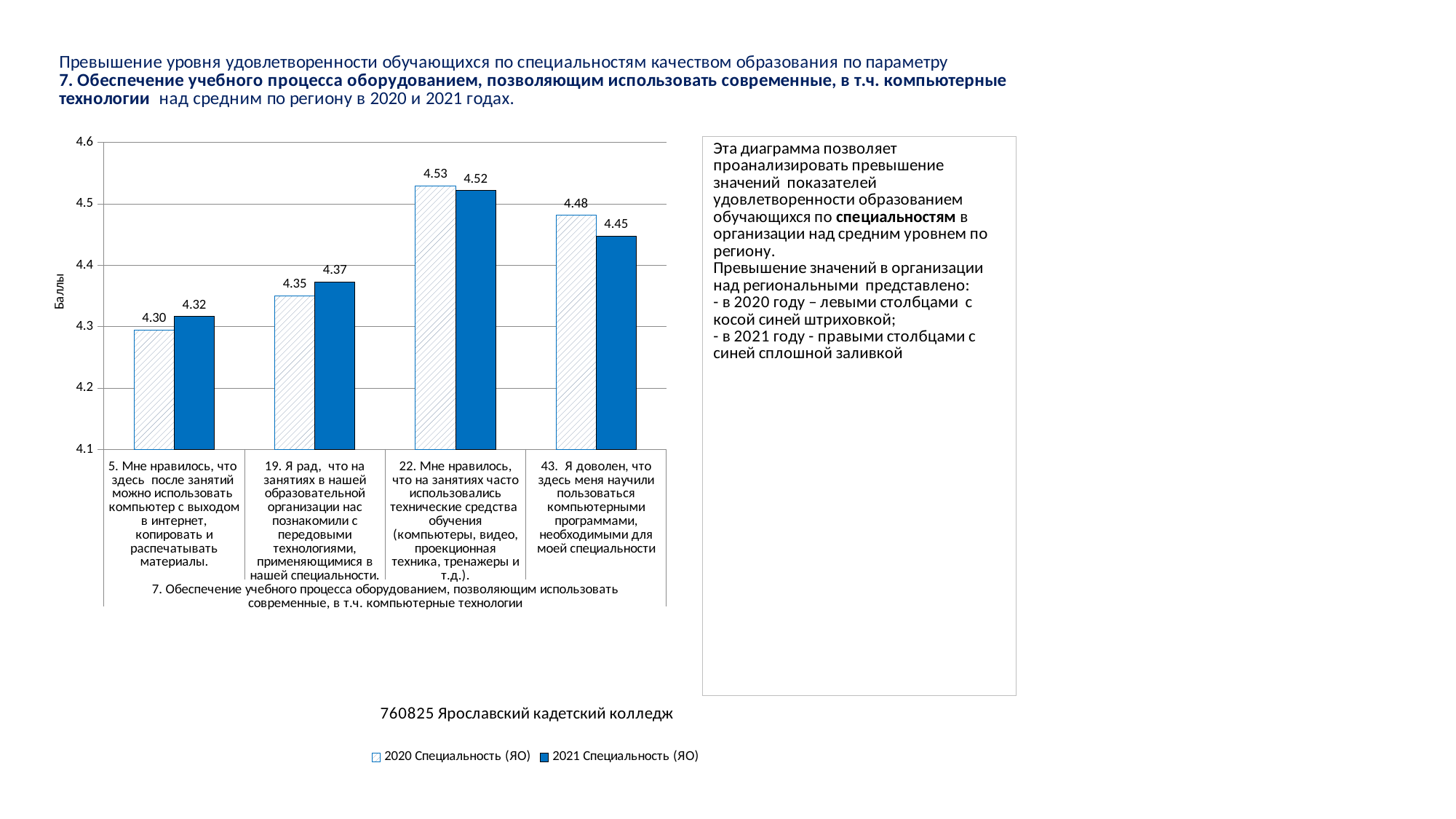
For statement 22, which is larger: the 2020 value or the 2021 value? 2020 (4.53) What type of chart is shown? bar chart Is the 2020 value for statement 19 greater or less than 4.4? less What is the 2021 Специальность (ЯО) value for statement 43 ("Я доволен, что здесь меня научили пользоваться компьютерными программами...")? 4.45 What is the 2020 Специальность (ЯО) value for statement 5 ("Мне нравилось, что здесь после занятий можно использовать компьютер с выходом в интернет...")? 4.30 Which statement has the lowest 2021 Специальность (ЯО) value? 5. Мне нравилось, что здесь после занятий можно использовать компьютер с выходом в интернет What is the label of the vertical axis? Баллы How many series does the legend list? 2 How many statements (categories) are shown on the x axis? 4 What is the difference between the 2020 and 2021 values for statement 43? 0.03 What is the 2021 Специальность (ЯО) value for statement 19 ("Я рад, что на занятиях в нашей образовательной организации нас познакомили с передовыми технологиями...")? 4.37 Which statement has the highest 2020 Специальность (ЯО) value? 22. Мне нравилось, что на занятиях часто использовались технические средства обучения